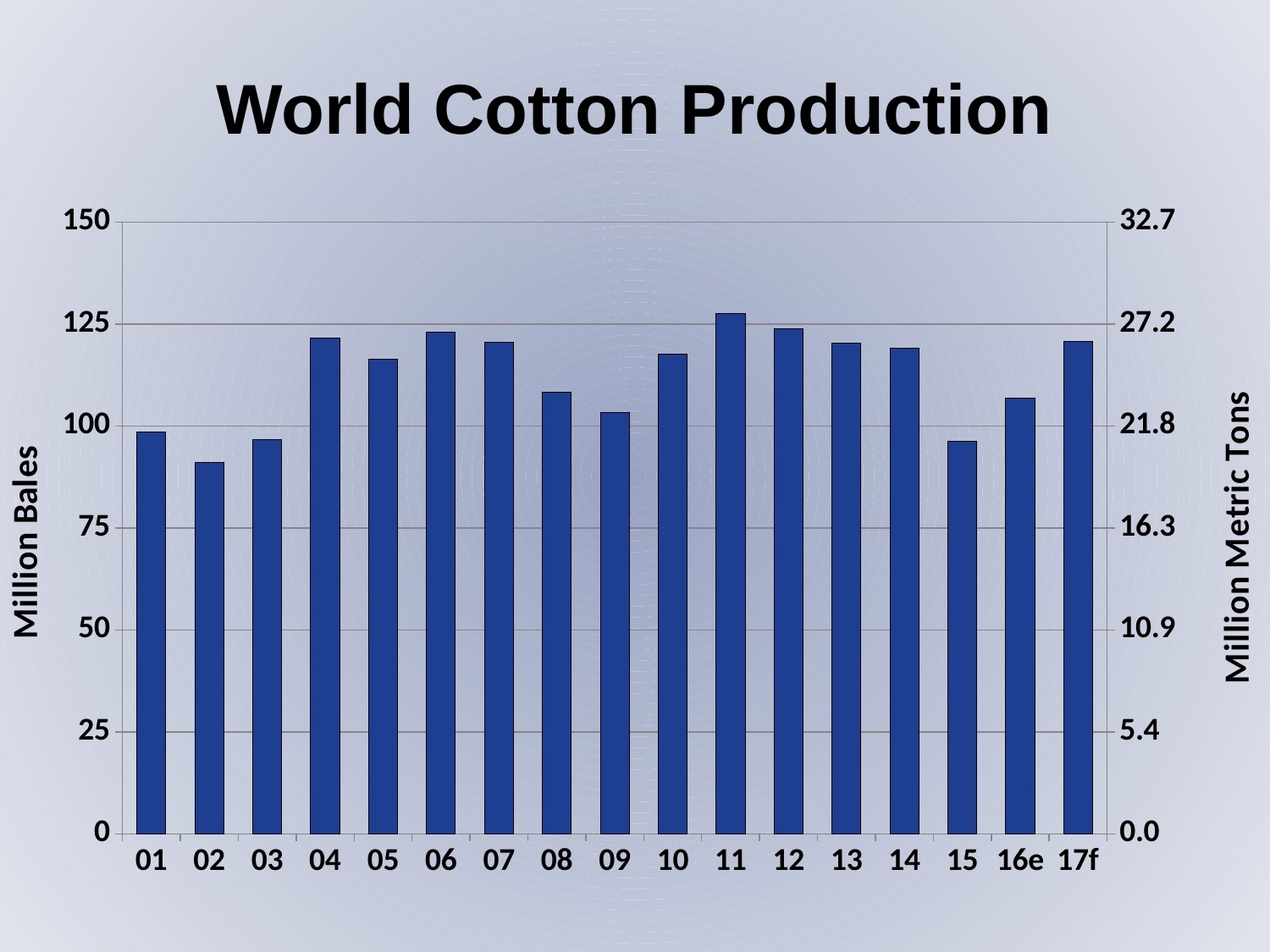
Which year has the lowest world cotton production? 02 What is the title of the chart? World Cotton Production Which year has the highest world cotton production? 11 Is the value for 15 greater or less than 100 million bales? less Is the value for 16e greater or less than 100 million bales? greater Is the value for 04 greater or less than 100 million bales? greater How many years (bars) are shown on the x axis? 17 Do the values rise or fall from 11 to 15? fall What is the label of the right-hand vertical axis? Million Metric Tons What type of chart is shown on the slide? Bar chart Which is larger, the value for 08 or the value for 09? 08